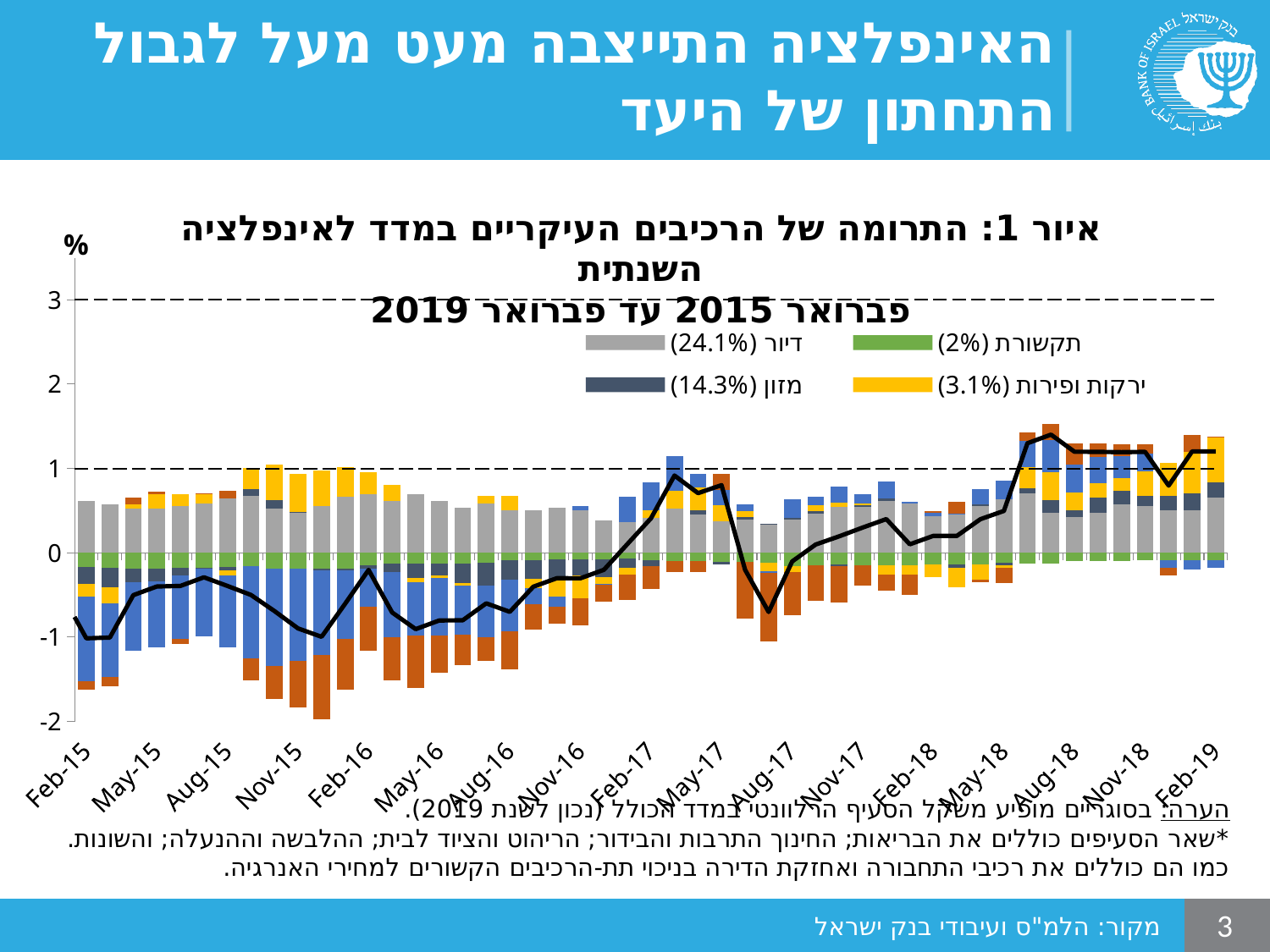
What is the title of the chart? איור 1: התרומה של הרכיבים העיקריים במדד לאינפלציה השנתית פברואר 2015 עד פברואר 2019 Does the black line rise or fall between Aug-17 and Aug-18? rise Is the value of the black line at Feb-19 greater or less than 1? greater Is the value of the black line at Aug-18 greater or less than 1? greater How many month labels are shown on the x axis? 17 Is the value of the black line at Feb-15 greater or less than 0? less Around which labelled month does the black line reach its highest point? Aug-18 What kind of chart is shown on the slide? Stacked bar chart with a line Which is larger, the black line value at Feb-19 or at Feb-15? Feb-19 What weight is shown in the legend next to מזון? 14.3% How many series does the visible legend list? 4